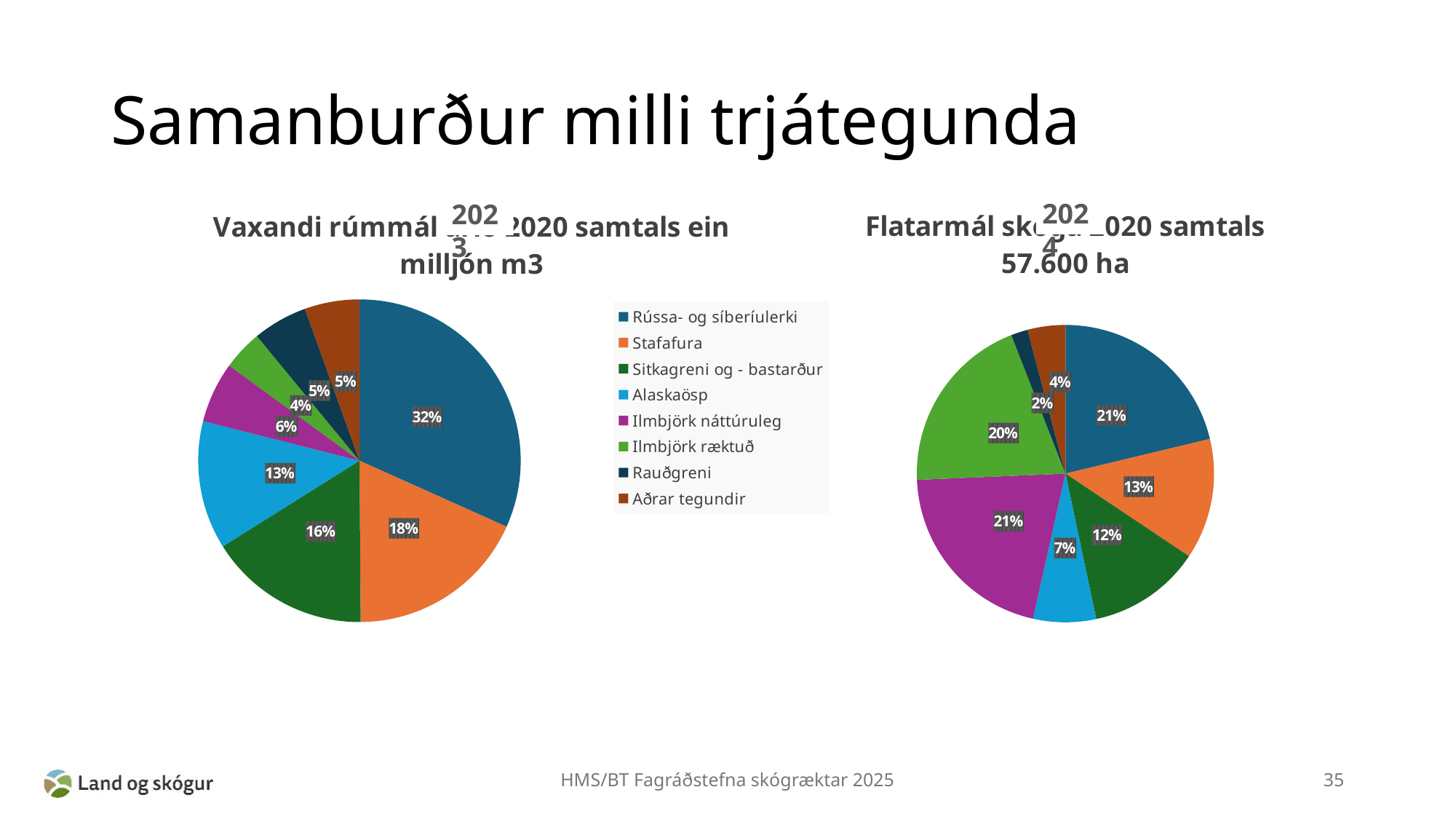
Which colour represents Stafafura in the pie charts? Orange In the left pie chart, which category has the largest share? Rússa- og síberíulerki How many categories does the legend list for the pie charts? 8 In the right pie chart, what share does Ilmbjörk ræktuð have? 20% In the left pie chart, what share does Alaskaösp have? 13% What type of chart is shown on the right side of the slide? Pie chart In the left pie chart, what is the difference between the shares of Stafafura and Sitkagreni og - bastarður? 2% In the right pie chart, which is larger: the share of Stafafura or the share of Alaskaösp? Stafafura In the right pie chart, what is the difference between the shares of Rússa- og síberíulerki and Sitkagreni og - bastarður? 9% In the right pie chart, which category has the smallest share? Rauðgreni In the right pie chart, what share does Rauðgreni have? 2% In the left pie chart, what share does Rússa- og síberíulerki have? 32%